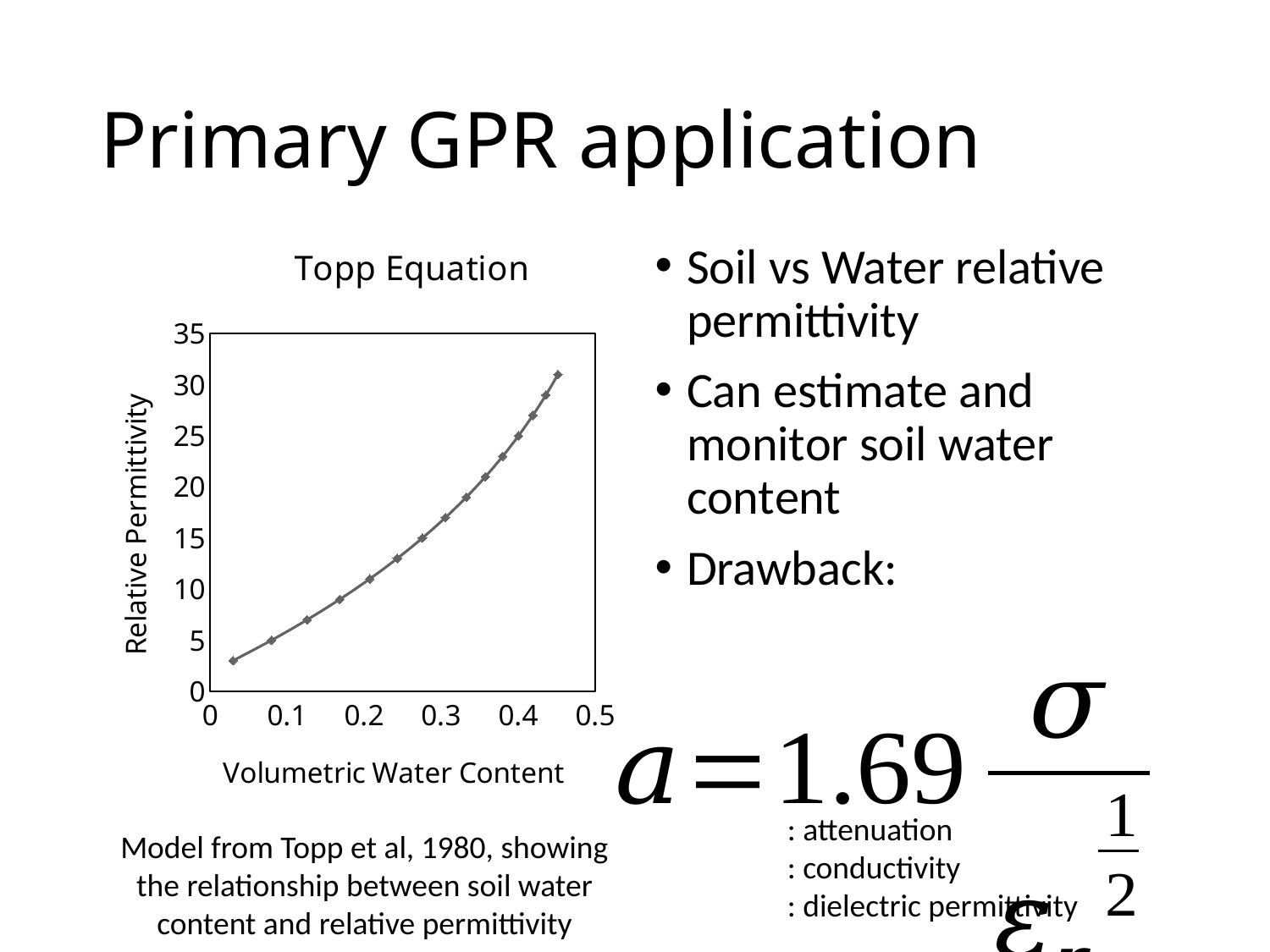
What is the label of the x axis of the Topp Equation chart? Volumetric Water Content In the Topp Equation chart, is the relative permittivity at a volumetric water content of 0.3 greater or less than 15? greater What is the title of the chart on the slide? Topp Equation What kind of chart is the Topp Equation chart? line chart In the Topp Equation chart, is the relative permittivity at a volumetric water content of 0.4 greater or less than 20? greater In the Topp Equation chart, is the highest plotted relative permittivity greater or less than 35? less In the Topp Equation chart, which has the larger relative permittivity: a volumetric water content of 0.2 or 0.4? 0.4 In the Topp Equation chart, does relative permittivity rise or fall as volumetric water content increases? rise